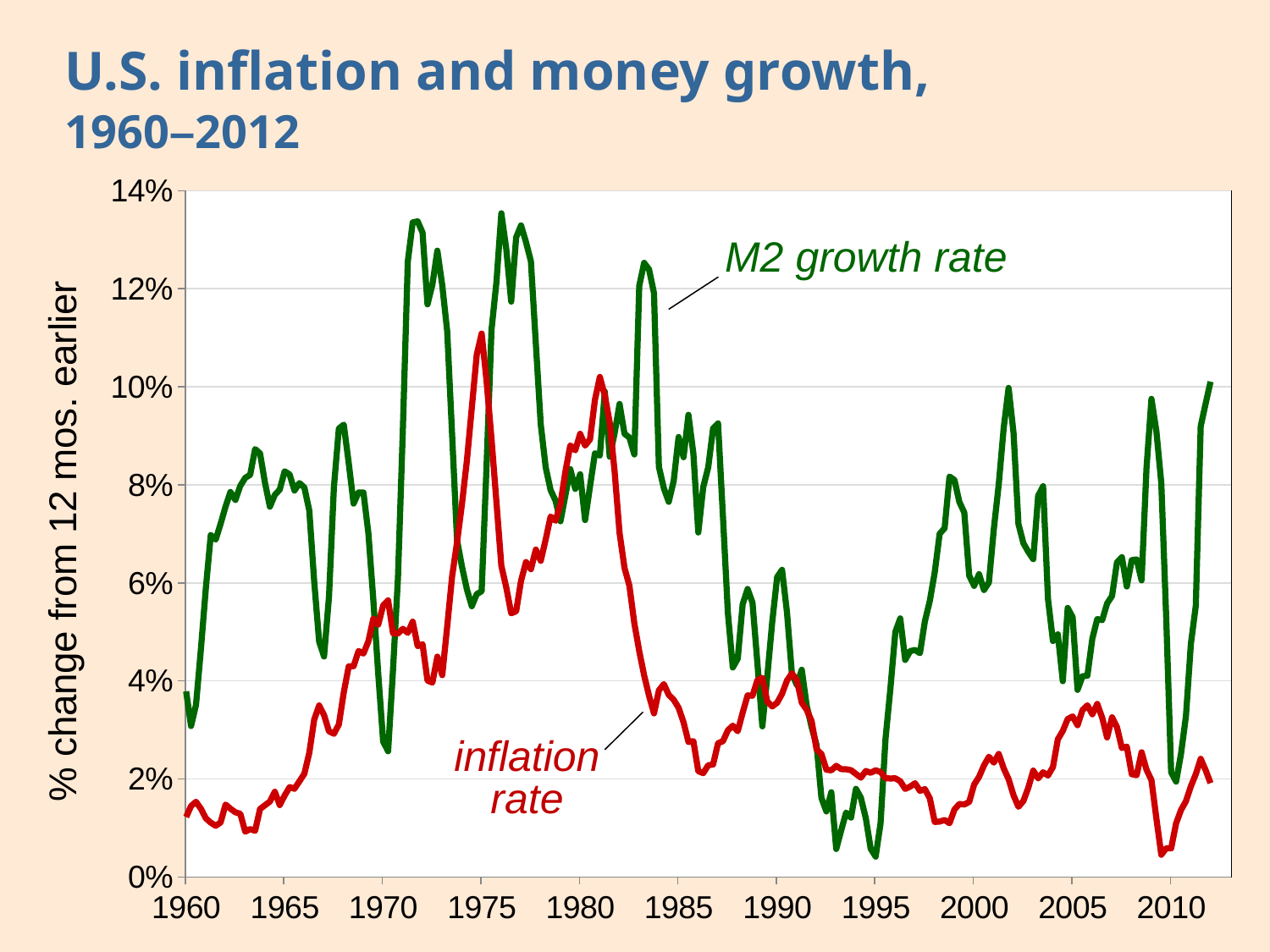
Does the inflation rate generally rise or fall between 1980 and 1985? fall What colour is the line for the M2 growth rate? green What is the title of the chart? U.S. inflation and money growth, 1960–2012 Is the inflation rate in 1975 greater or less than 8%? greater Is the M2 growth rate in 1995 greater or less than 2%? less What kind of chart is shown on the slide? line chart Is the M2 growth rate around 1972 greater or less than 12%? greater In 1995, which series has the higher value, the inflation rate or the M2 growth rate? inflation rate In 1965, which series has the higher value, the inflation rate or the M2 growth rate? M2 growth rate Which series reaches the higher peak value over the whole period? M2 growth rate How many data series are plotted on the chart? 2